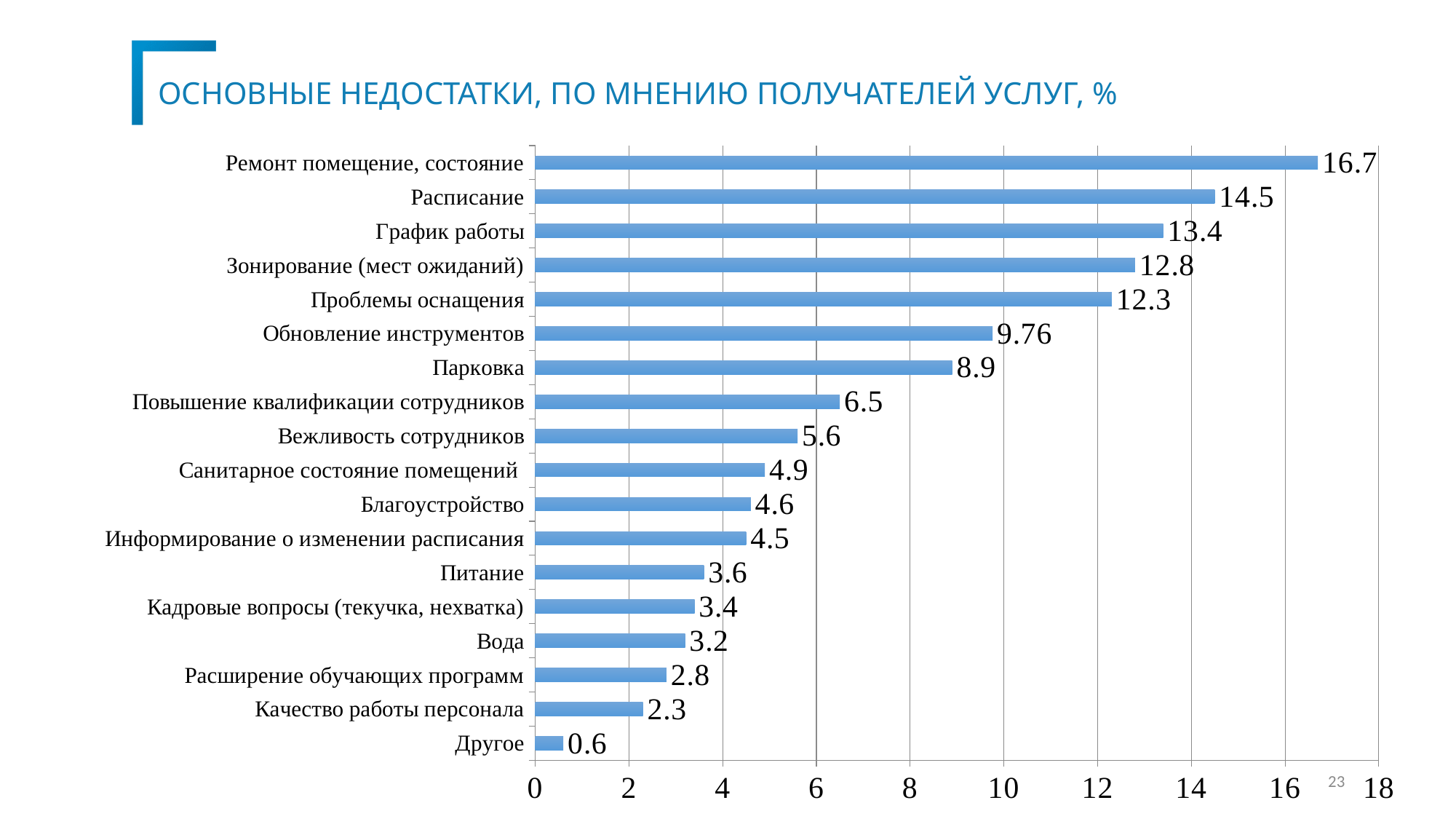
Which category has the lowest value? Другое What is the value for Расписание? 14.5 What is the title of the chart? ОСНОВНЫЕ НЕДОСТАТКИ, ПО МНЕНИЮ ПОЛУЧАТЕЛЕЙ УСЛУГ, % What is the difference between the values for Вежливость сотрудников and Санитарное состояние помещений? 0.7 Is the value for Зонирование (мест ожиданий) greater or less than 12? greater What is the value for Парковка? 8.9 How many categories are shown in the chart? 18 What is the value for Обновление инструментов? 9.76 What kind of chart is shown on the slide? Bar chart Which category has the highest value? Ремонт помещение, состояние What is the difference between the values for Ремонт помещение, состояние and Расписание? 2.2 Which is larger, the value for Питание or the value for Вода? Питание